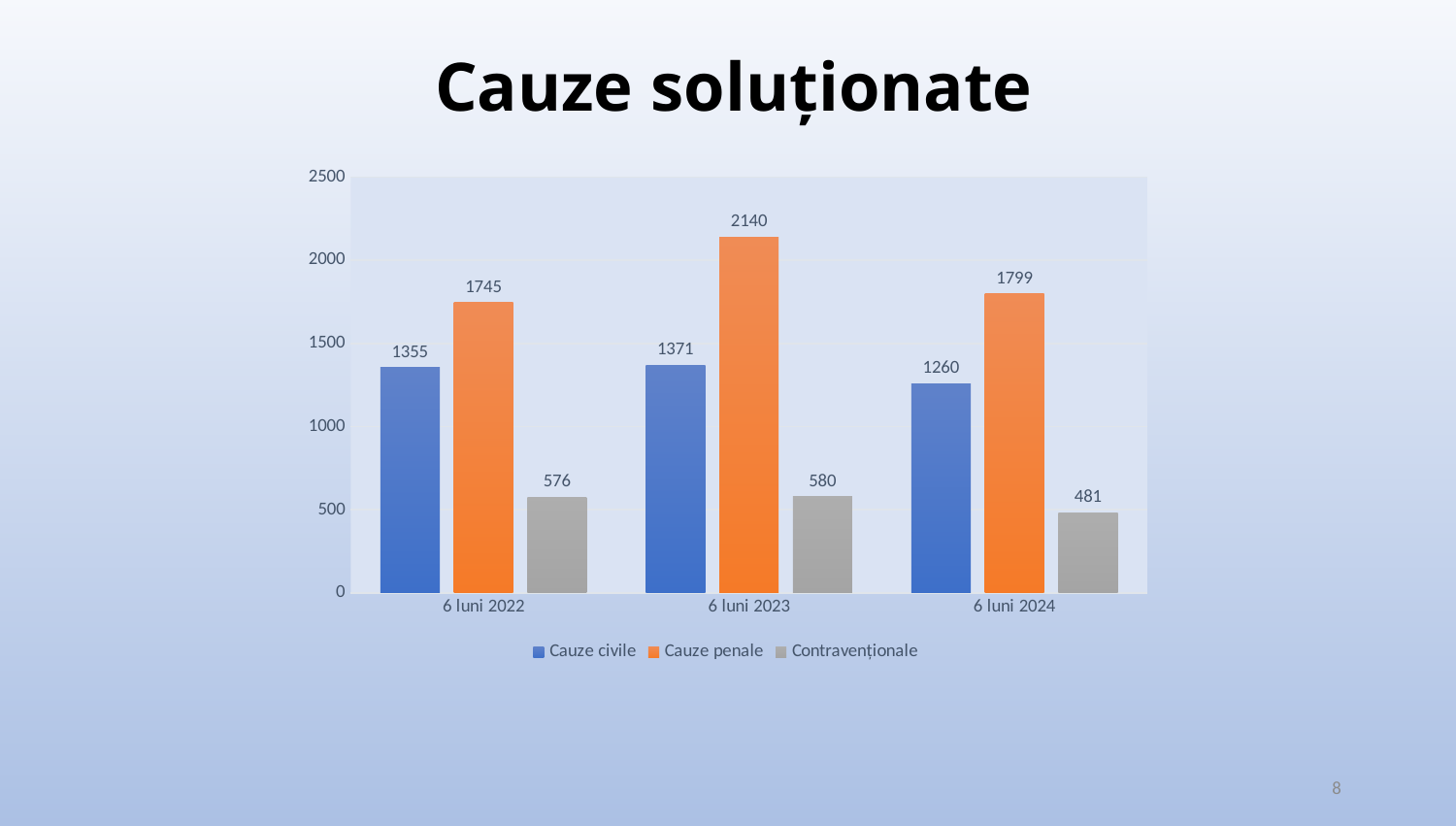
What is the value for Cauze penale in 6 luni 2023? 2140 What is the difference between Cauze penale and Cauze civile in 6 luni 2024? 539 Is the value for Cauze penale in 6 luni 2022 greater or less than 1500? greater What kind of chart is shown on the slide? bar chart Which is larger in 6 luni 2022: Cauze civile or Contravenționale? Cauze civile How many periods are shown on the x axis? 3 What is the title of the slide? Cauze soluționate In which period is the value for Cauze civile lowest? 6 luni 2024 How many series does the legend list? 3 What is the value for Cauze civile in 6 luni 2022? 1355 In which period is the value for Cauze penale highest? 6 luni 2023 What is the value for Contravenționale in 6 luni 2024? 481